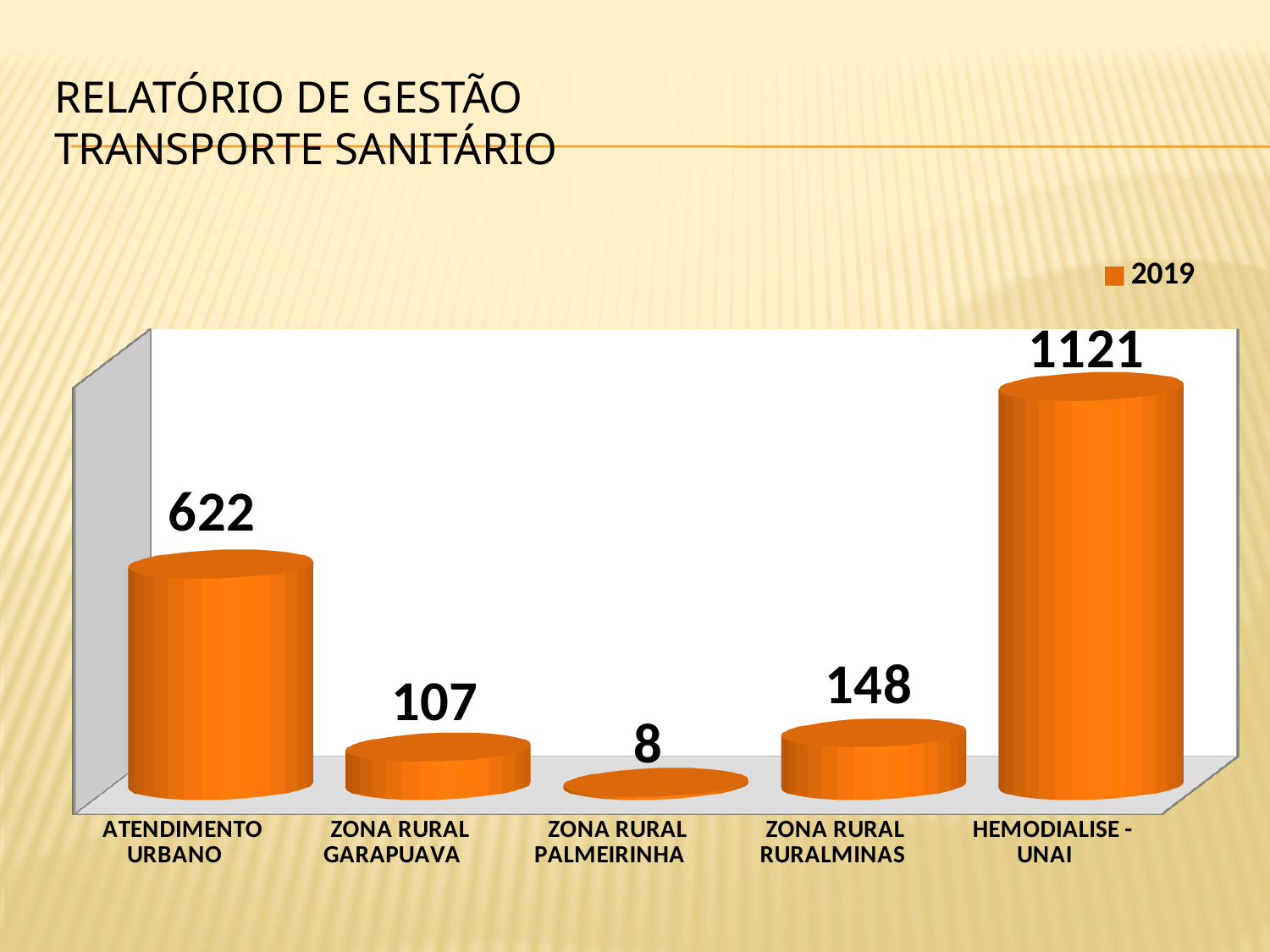
What is the value for HEMODIALISE - UNAI? 1121 What is the difference between the values for HEMODIALISE - UNAI and ATENDIMENTO URBANO? 499 How many categories are shown on the chart? 5 What is the difference between the values for ZONA RURAL RURALMINAS and ZONA RURAL GARAPUAVA? 41 What is the value for ATENDIMENTO URBANO? 622 What kind of chart is shown on the slide? bar chart Which is larger, the value for ZONA RURAL RURALMINAS or ZONA RURAL GARAPUAVA? ZONA RURAL RURALMINAS How many series does the legend list? 1 Which category has the lowest value? ZONA RURAL PALMEIRINHA Which category has the highest value? HEMODIALISE - UNAI What is the value for ZONA RURAL GARAPUAVA? 107 What is the value for ZONA RURAL PALMEIRINHA? 8